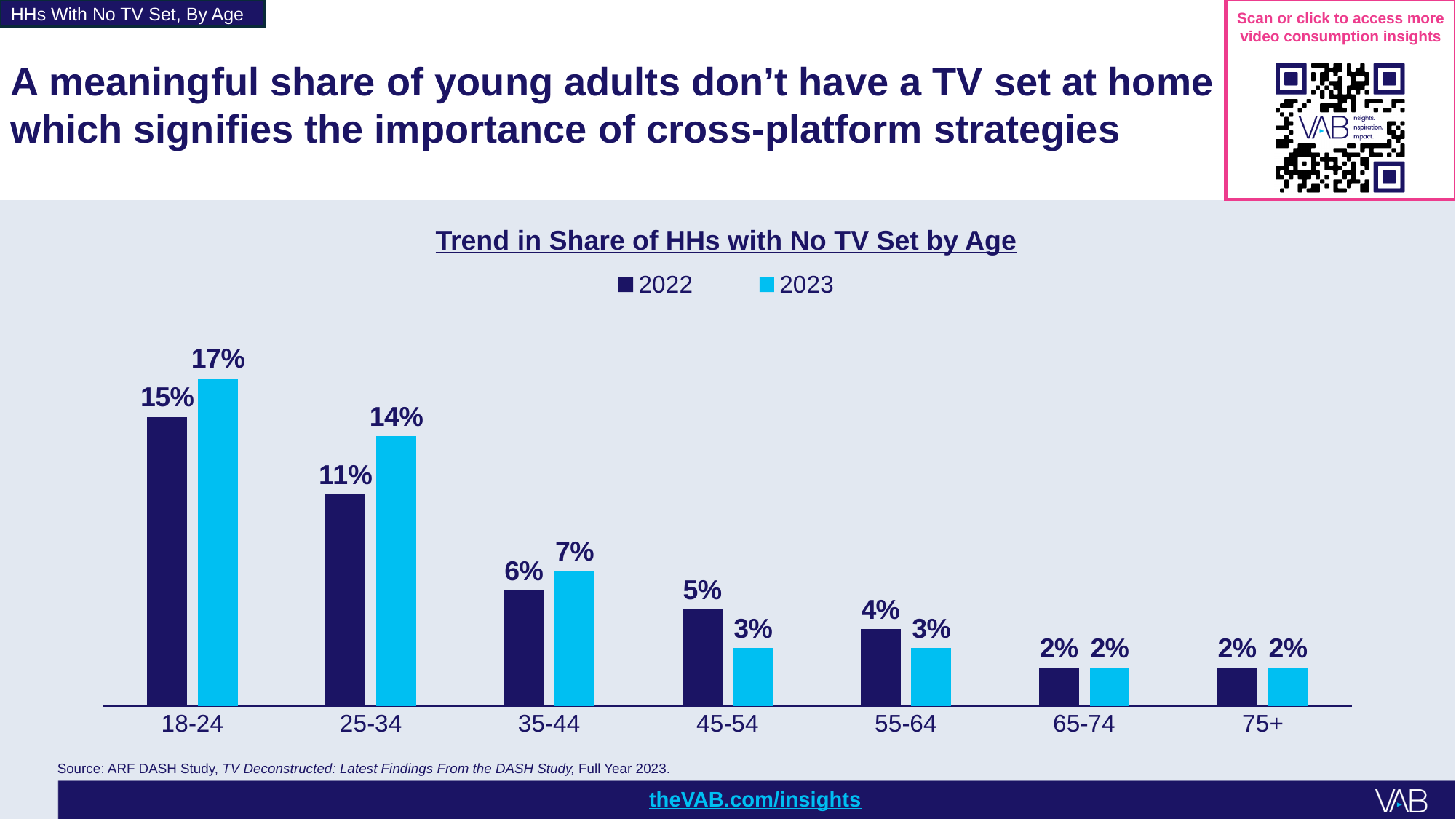
How many series does the legend list? 2 Which age group has the lowest 2023 value? 65-74 and 75+ What is the 2022 value for the 25-34 age group? 11% Which age group has the highest 2022 value? 18-24 What is the title of the chart? Trend in Share of HHs with No TV Set by Age What is the difference between the 2023 and 2022 values for the 25-34 age group? 3% For the 55-64 age group, which year has the larger value, 2022 or 2023? 2022 Do the 2023 values rise or fall as age increases along the x axis? Fall What kind of chart is shown on the slide? Bar chart How many age groups are shown on the x axis? 7 What is the 2023 value for the 18-24 age group? 17% What is the 2023 value for the 45-54 age group? 3%